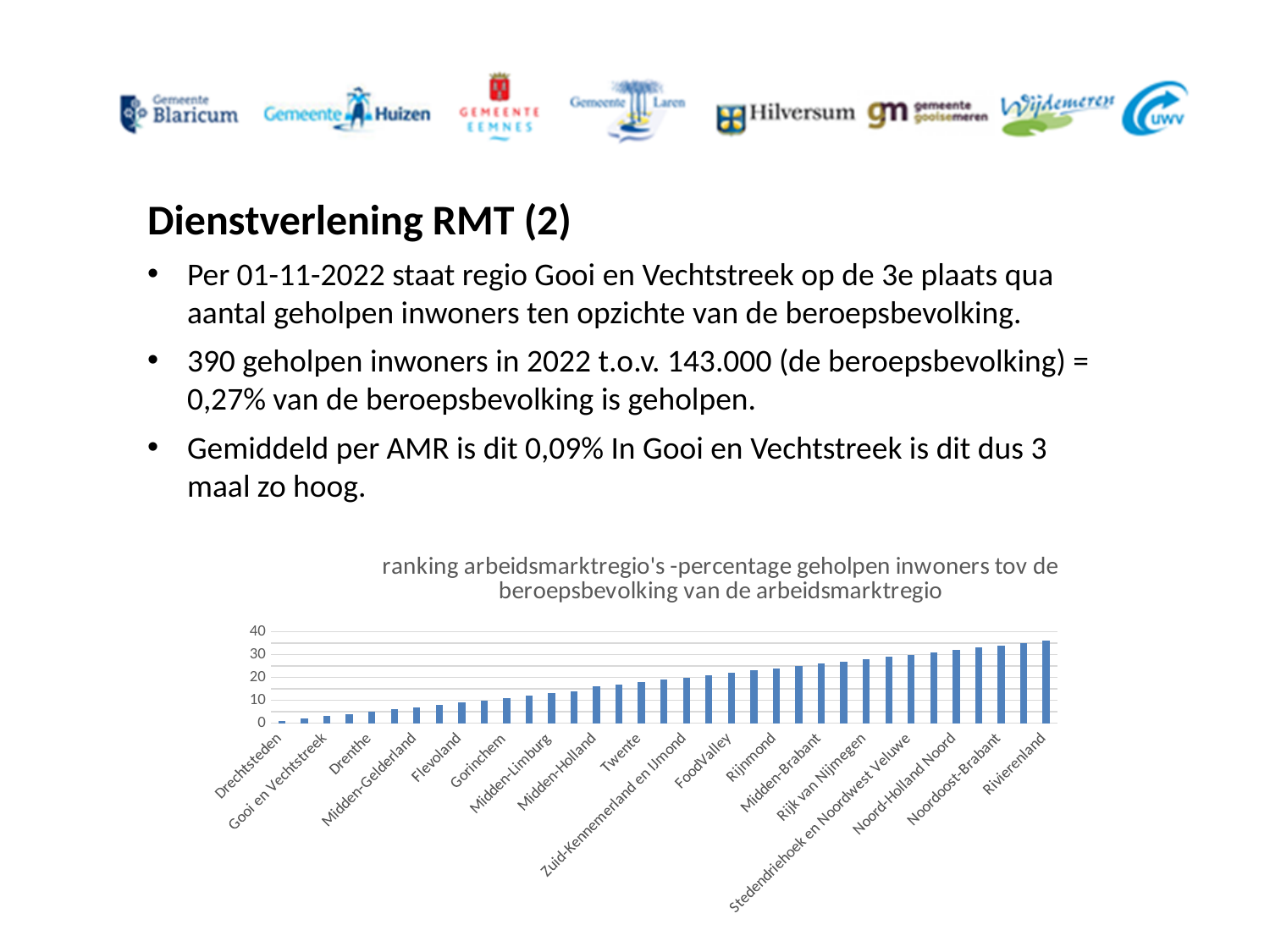
Do the values rise or fall from left to right along the x axis? rise What is the highest value shown on the vertical axis of the chart? 40 Which has the larger value, Rijnmond or Twente? Rijnmond Is the value for Rijnmond greater or less than 20? greater Is the value for Drechtsteden greater or less than 10? less Is the value for Twente greater or less than 20? less What kind of chart is shown on the slide? bar chart Which has the larger value, Gooi en Vechtstreek or Noordoost-Brabant? Noordoost-Brabant Which labelled region has the highest value in the chart? Rivierenland Which labelled region has the lowest value in the chart? Drechtsteden